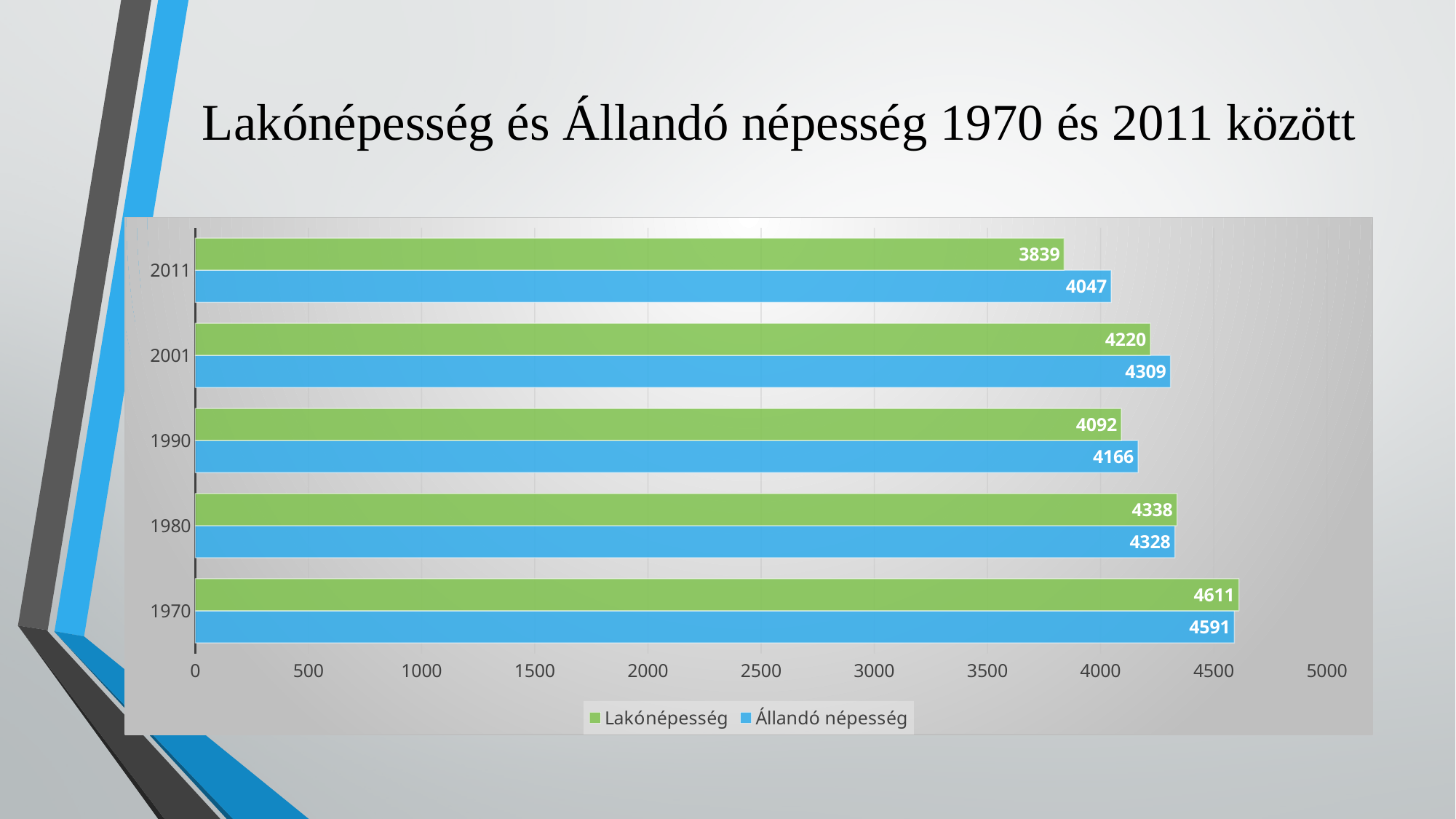
What is the difference between Állandó népesség and Lakónépesség in 2011? 208 What is the Lakónépesség value for 2011? 3839 Which year has the lowest Lakónépesség value? 2011 What kind of chart is shown on the slide? Bar chart What is the Lakónépesség value for 1980? 4338 In 2001, which is larger: Lakónépesség or Állandó népesség? Állandó népesség How many series does the legend list? 2 How many years are shown on the chart? 5 What is the difference between the Lakónépesség values for 1970 and 2011? 772 Which year has the highest Állandó népesség value? 1970 What is the Állandó népesség value for 1990? 4166 Which colour represents Állandó népesség in the chart? Blue